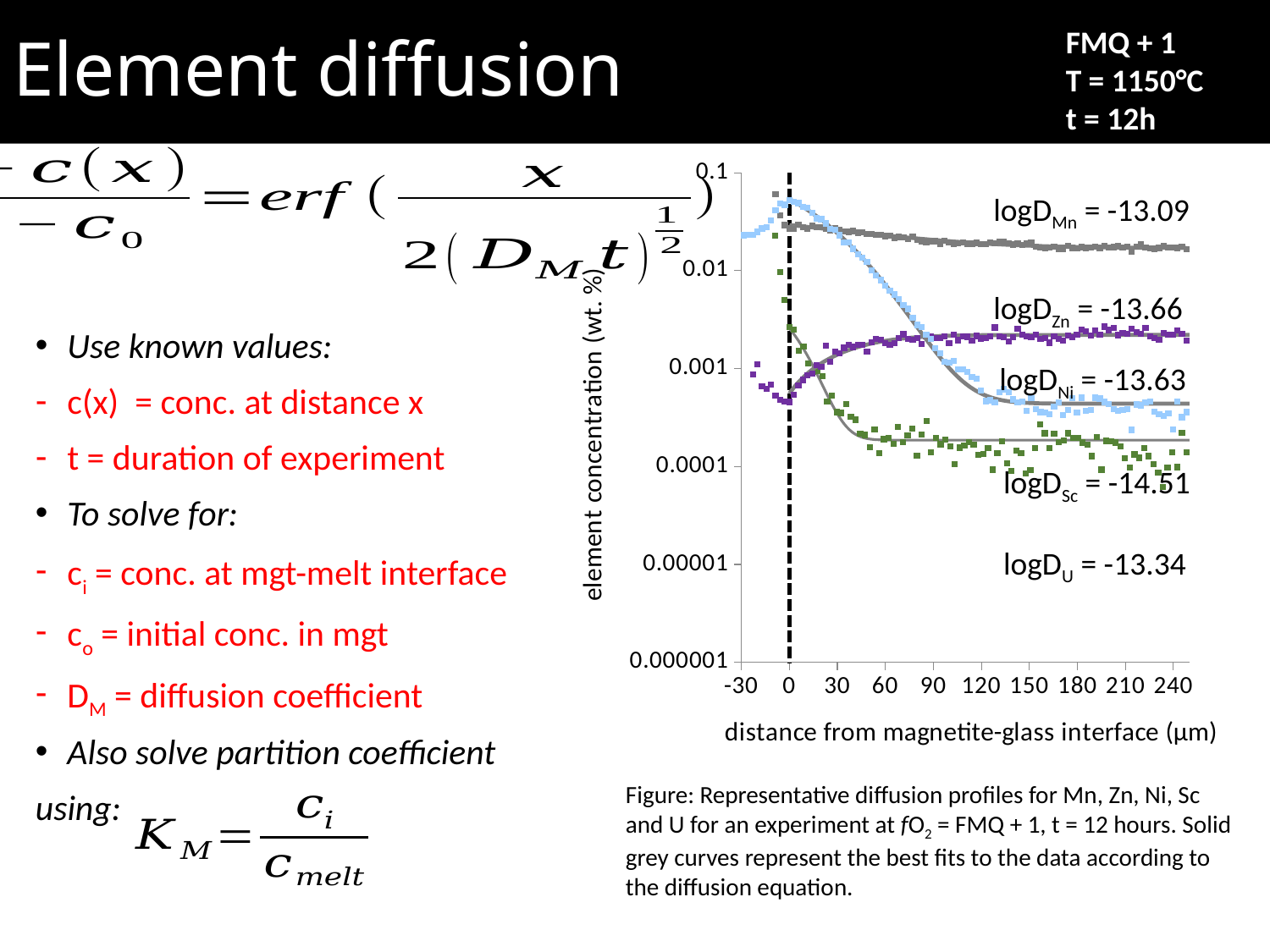
Does the Zn concentration (purple points) rise or fall with increasing distance from the interface? rise What is the label of the x axis of the chart? distance from magnetite-glass interface (μm) What is the difference between the logD values for Mn and Zn? 0.57 Which element has the lowest logD value annotated on the chart? Sc What is the value of logD for U shown on the chart? -13.34 What is the value of logD for Sc shown on the chart? -14.51 Which is larger, the logD value for Ni or the logD value for Zn? Ni What is the value of logD for Mn shown on the chart? -13.09 Which element has the highest logD value annotated on the chart? Mn Is the Ni concentration at 240 μm greater or less than 0.001 wt. %? less Is the Mn concentration at 240 μm greater or less than 0.01 wt. %? greater Does the Ni concentration (light blue points) rise or fall with increasing distance from the interface? fall